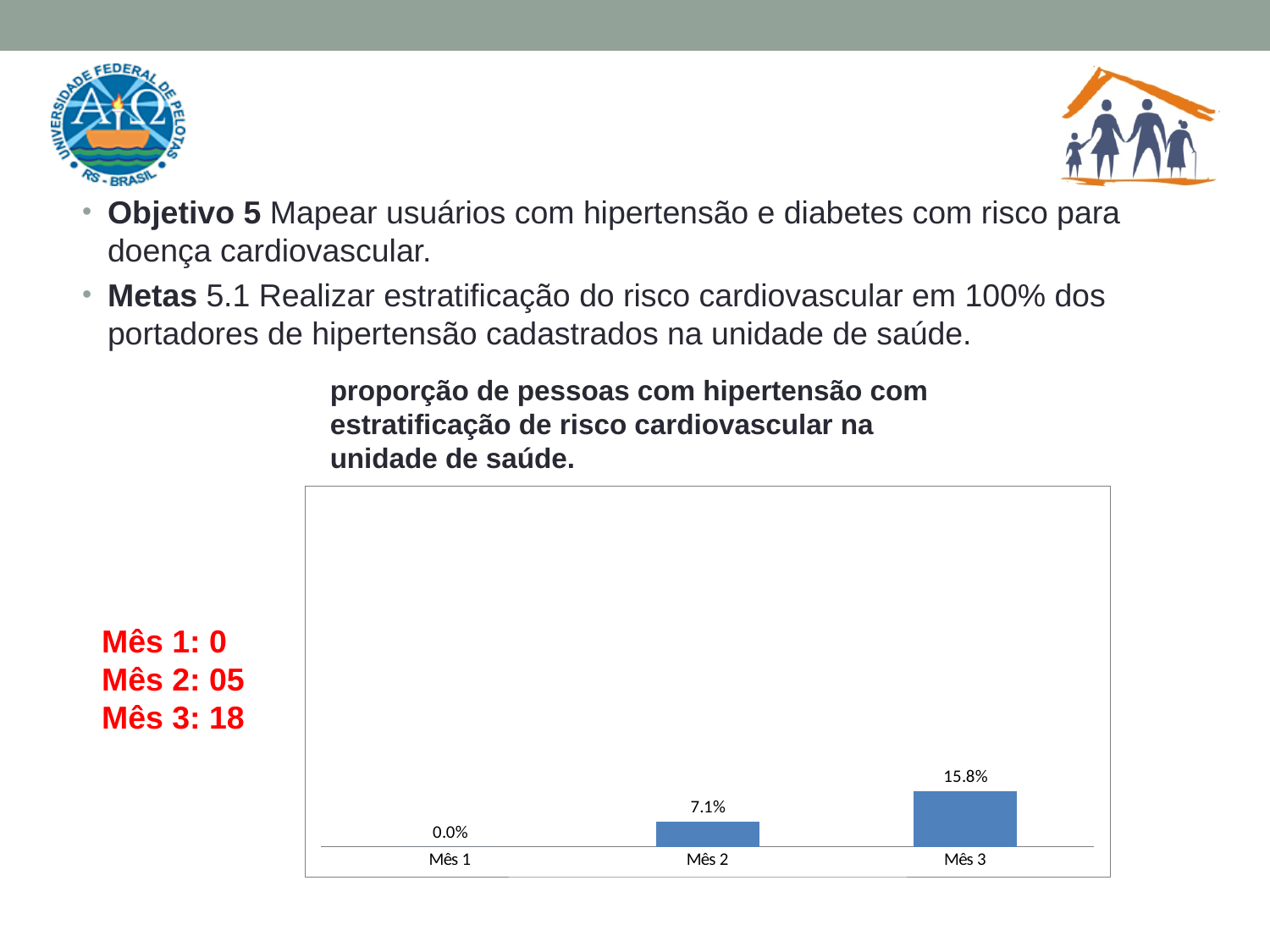
Which is larger, the value for Mês 2 or the value for Mês 3? Mês 3 What is the title of the chart? proporção de pessoas com hipertensão com estratificação de risco cardiovascular na unidade de saúde. What colour are the bars in the chart? Blue What is the difference between the values for Mês 3 and Mês 2? 8.7% What is the value for Mês 3? 15.8% Which month has the lowest value? Mês 1 What is the value for Mês 1? 0.0% What kind of chart is shown on the slide? Bar chart What is the value for Mês 2? 7.1% Which month has the highest value? Mês 3 Do the values rise or fall from Mês 1 to Mês 3? Rise How many months are shown on the x axis? 3